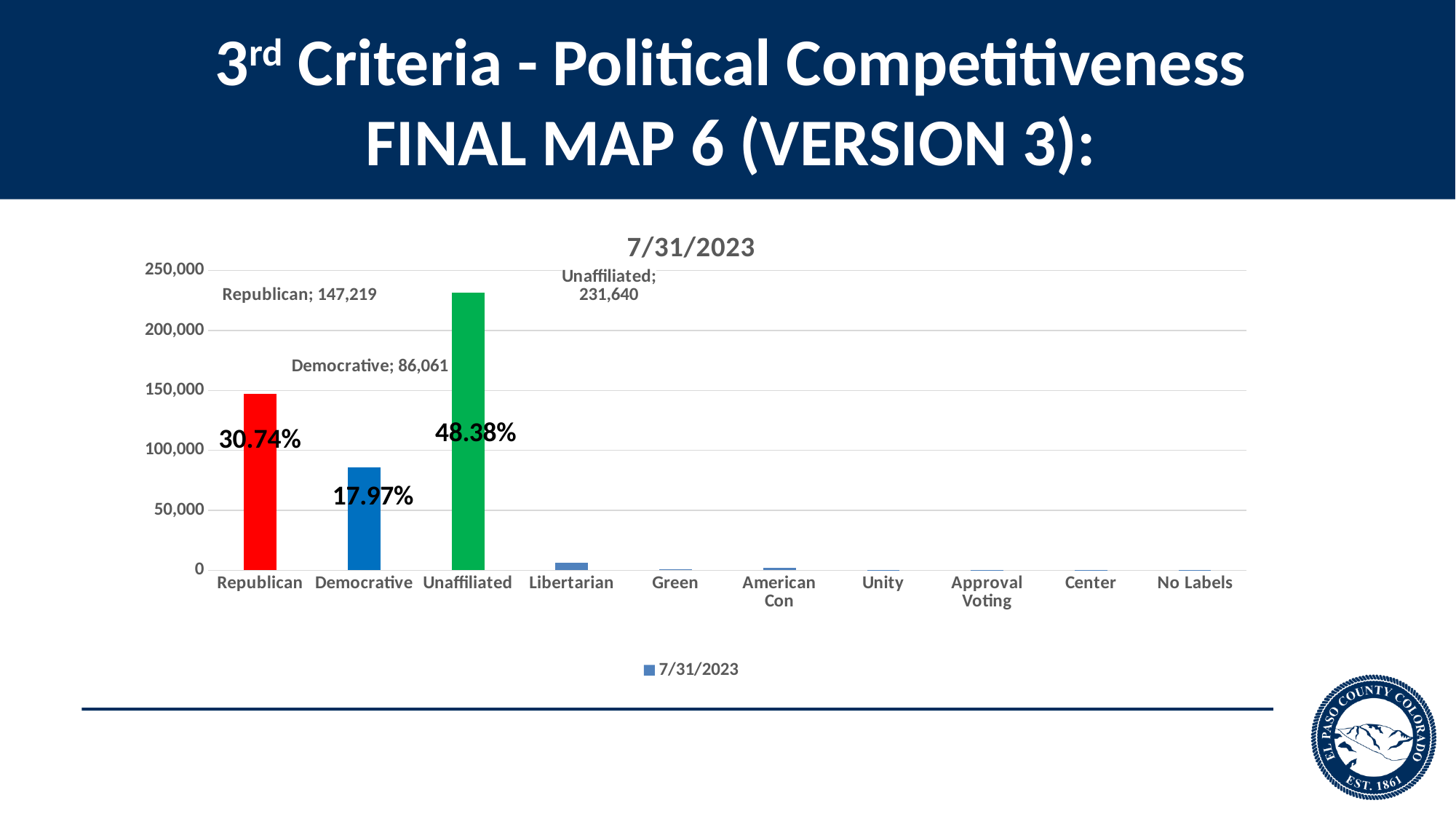
What is the difference between the Unaffiliated and Republican values? 84,421 What is the value for Republican? 147,219 Which is larger, the value for Republican or the value for Democrative? Republican Is the value for Libertarian greater or less than 50,000? less What is the value for Unaffiliated? 231,640 What percentage is shown on the Democrative bar? 17.97% What percentage is shown on the Unaffiliated bar? 48.38% How many categories are shown on the x axis? 10 How many series does the legend list? 1 What is the value for Democrative? 86,061 What kind of chart is shown on the slide? bar chart Which category has the highest value? Unaffiliated